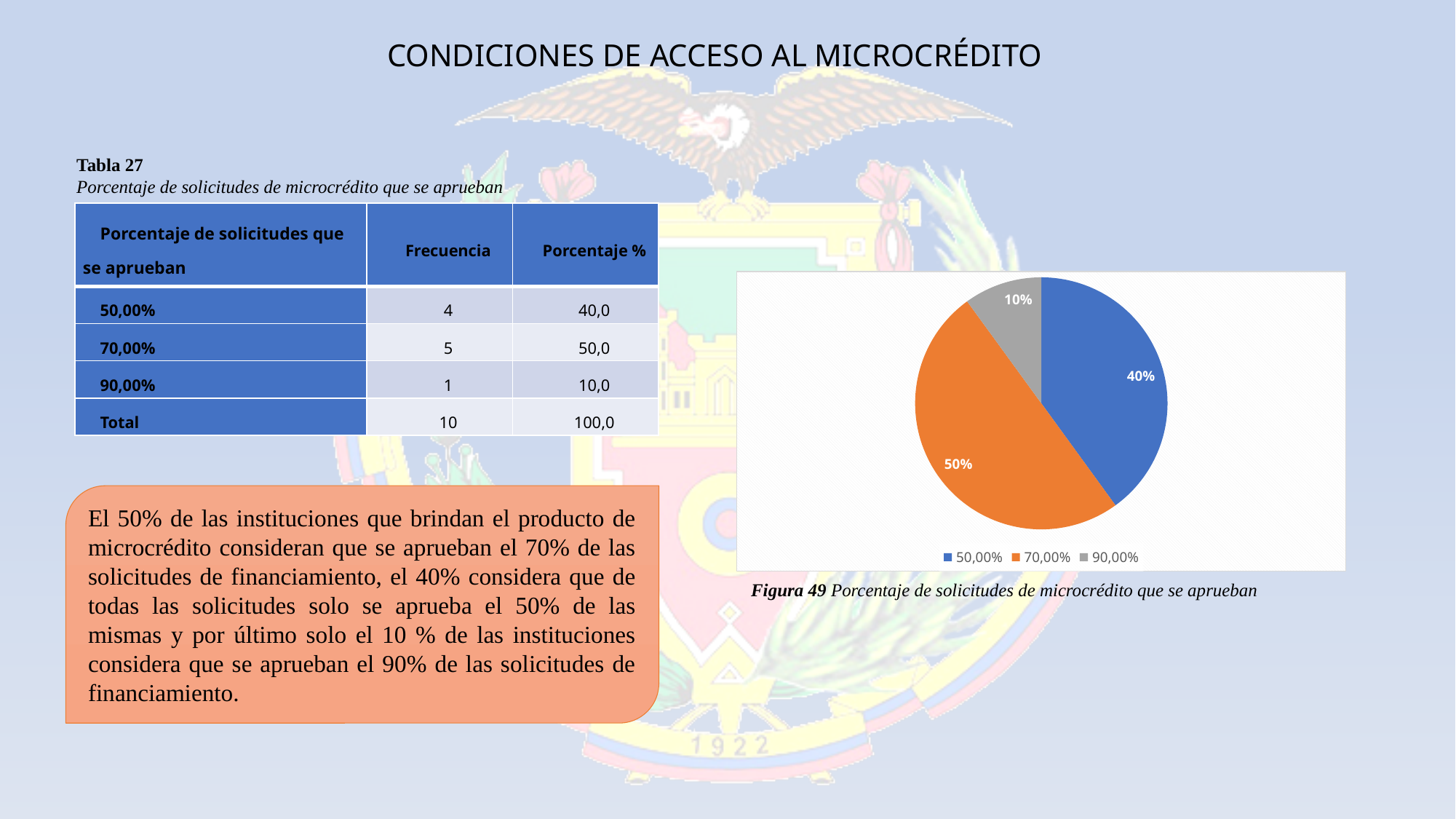
How many entries does the legend list? 3 Which category has the smallest slice of the pie? 90,00% What is the difference in percentage points between the 70,00% slice and the 50,00% slice? 10% What is the difference in percentage points between the 50,00% slice and the 90,00% slice? 30% What kind of chart is shown on the slide? pie chart What share of the pie does the 90,00% category have? 10% What share of the pie does the 70,00% category have? 50% Which category has the largest slice of the pie? 70,00% Which slice is larger, 50,00% or 90,00%? 50,00% What share of the pie does the 50,00% category have? 40% What colour is the slice for the 70,00% category? orange How many categories does the pie chart show? 3